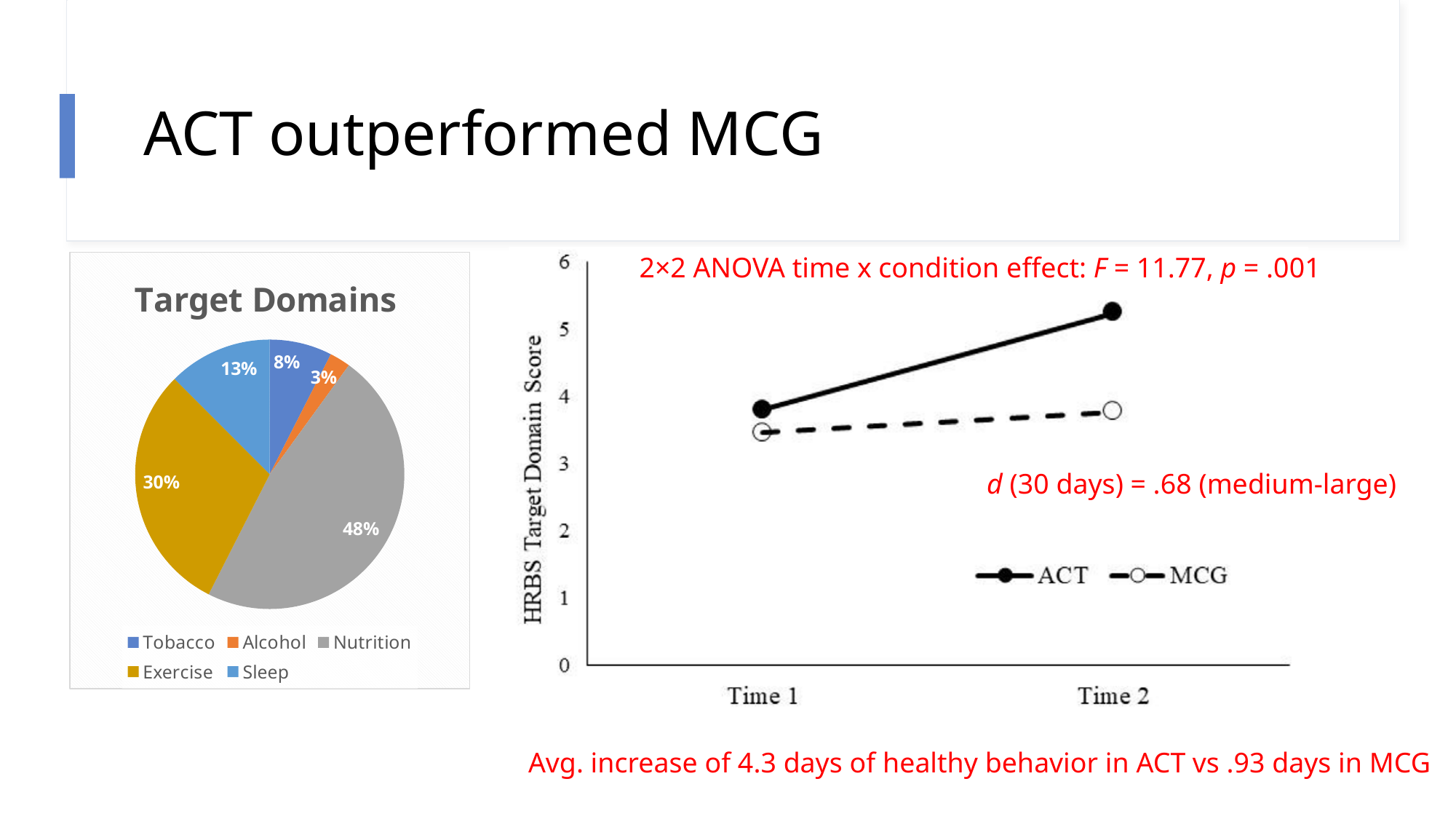
In the Target Domains pie chart, what share does Exercise have? 30% How many domains are shown in the Target Domains pie chart? 5 In the HRBS Target Domain Score chart on the right, how many series does the legend list? 2 In the Target Domains pie chart, what share does Sleep have? 13% In the HRBS Target Domain Score chart on the right, is the ACT value at Time 2 greater or less than 5? greater In the Target Domains pie chart, which domain has the smallest share? Alcohol In the Target Domains pie chart, which has a larger share, Tobacco or Sleep? Sleep In the HRBS Target Domain Score chart on the right, does the ACT score rise or fall from Time 1 to Time 2? Rise What type of chart is the Target Domains chart on the left? Pie chart In the Target Domains pie chart, what share does Nutrition have? 48% In the Target Domains pie chart, which domain has the largest share? Nutrition In the Target Domains pie chart, what is the difference between the Nutrition and Exercise shares? 18%